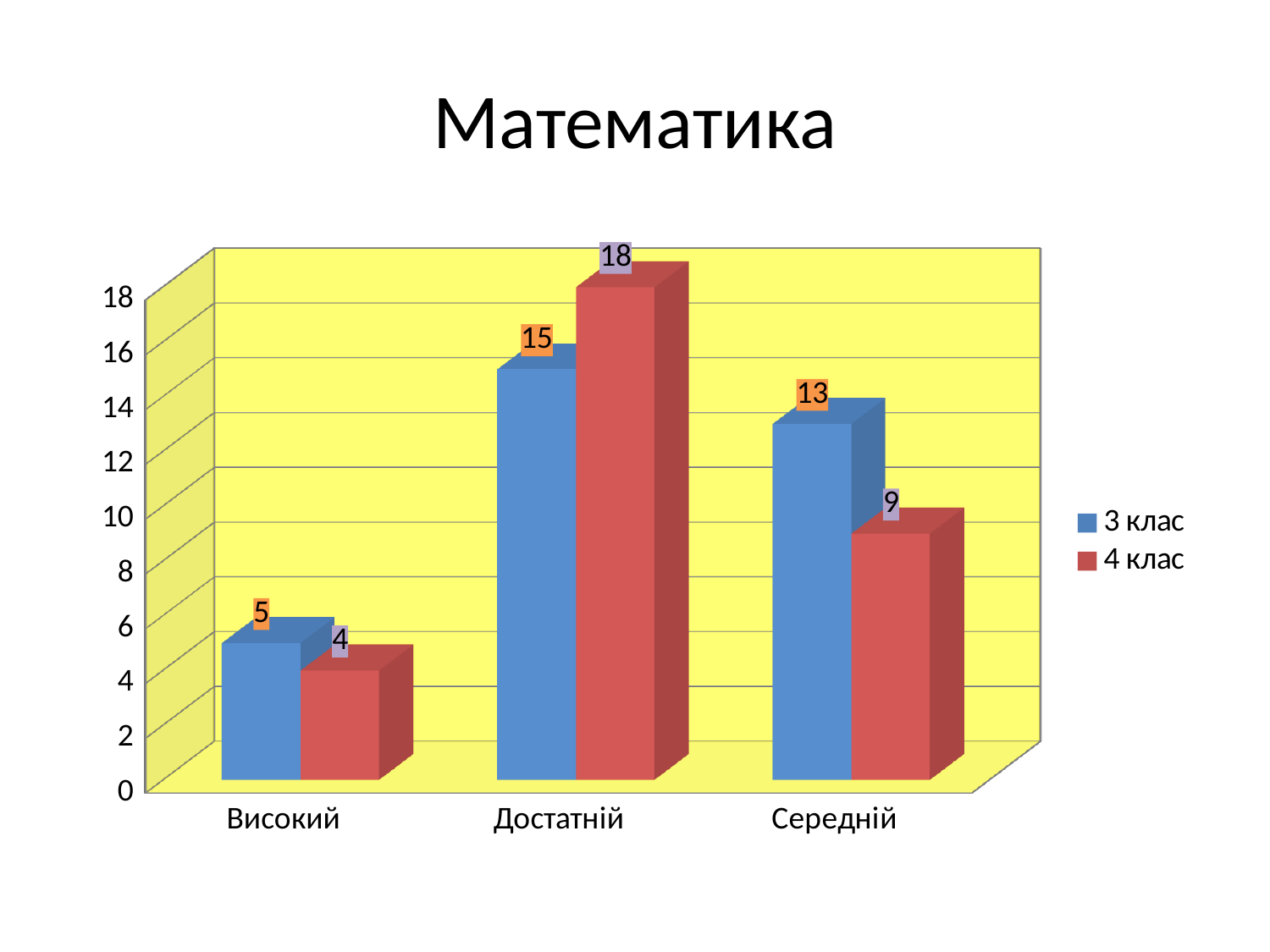
What is the value for 4 клас in the Високий category? 4 What is the title of the slide? Математика What is the value for 4 клас in the Середній category? 9 What is the value for 3 клас in the Достатній category? 15 In the Середній category, which series has the larger value, 3 клас or 4 клас? 3 клас How many categories are shown on the x axis? 3 What is the difference between the 4 клас and 3 клас values in the Достатній category? 3 Which category has the lowest value for 3 клас? Високий How many series does the legend list? 2 What kind of chart is shown on the slide? bar chart What is the difference between the 3 клас and 4 клас values in the Середній category? 4 Which category has the highest value for 4 клас? Достатній